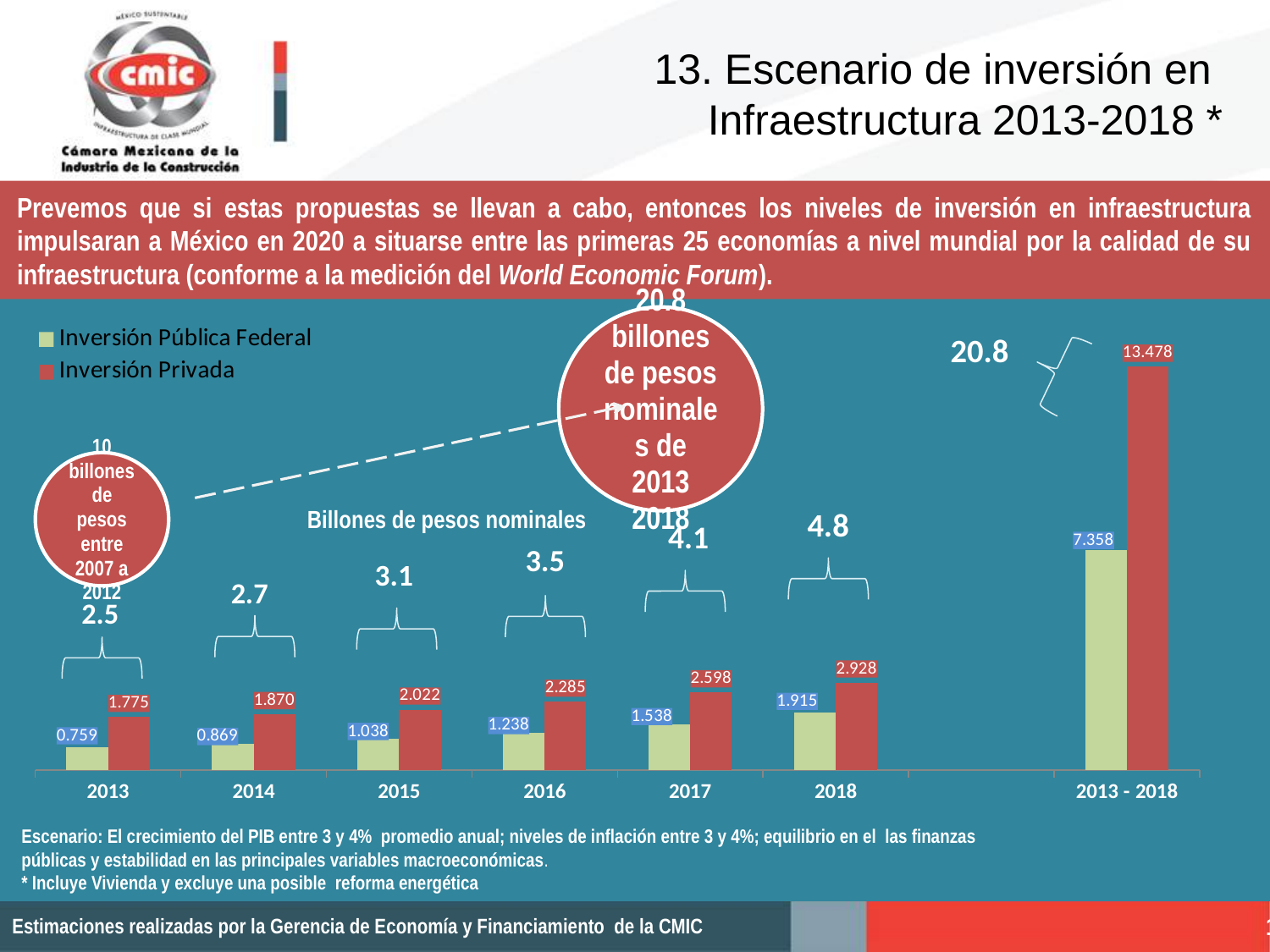
Among the single years 2013 to 2018, which year has the highest Inversión Privada value? 2018 Does the Inversión Pública Federal value rise or fall from 2013 to 2018? Rise How many series does the chart legend list? 2 How many categories are shown on the x axis of the chart? 7 What is the value of Inversión Privada for 2016? 2.285 What is the value of Inversión Pública Federal for the 2013 - 2018 category? 7.358 What kind of chart is shown on the slide? Bar chart Among the single years 2013 to 2018, which year has the lowest Inversión Pública Federal value? 2013 What is the difference between Inversión Privada and Inversión Pública Federal in 2017? 1.060 Which is larger in 2015: Inversión Pública Federal or Inversión Privada? Inversión Privada What is the value of Inversión Privada for 2018? 2.928 What is the value of Inversión Pública Federal for 2013? 0.759